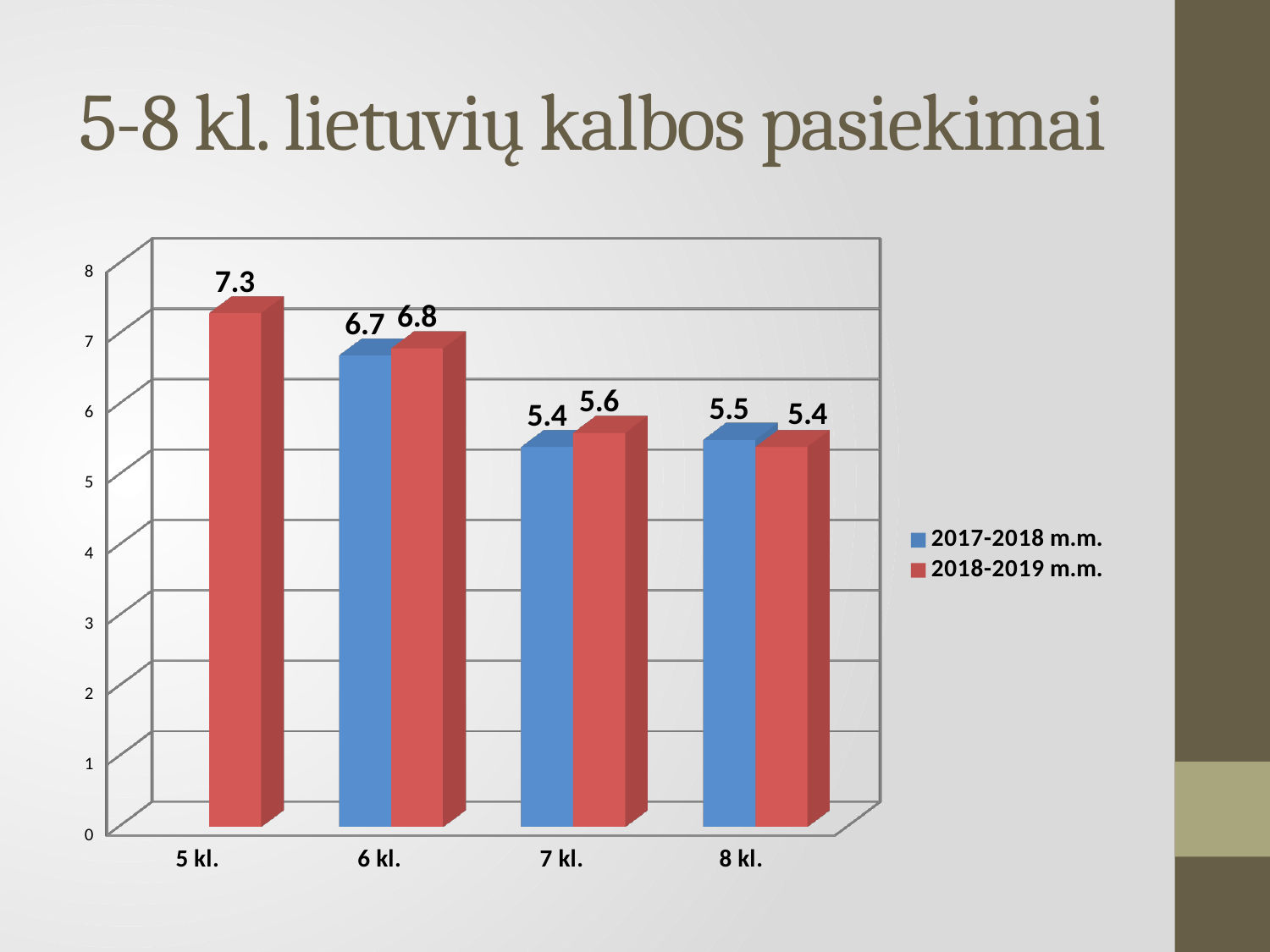
For 8 kl., which series has the larger value, 2017-2018 m.m. or 2018-2019 m.m.? 2017-2018 m.m. What is the value for 7 kl. in the 2018-2019 m.m. series? 5.6 How many classes are shown on the x axis? 4 What is the value for 6 kl. in the 2017-2018 m.m. series? 6.7 What is the title of the slide? 5-8 kl. lietuvių kalbos pasiekimai What is the value for 5 kl. in the 2018-2019 m.m. series? 7.3 What is the difference between the 2018-2019 m.m. and 2017-2018 m.m. values for 7 kl.? 0.2 What is the value for 8 kl. in the 2017-2018 m.m. series? 5.5 How many series does the legend list? 2 Which class has the highest value in the 2018-2019 m.m. series? 5 kl. What kind of chart is shown on the slide? Bar chart Which class has the lowest value in the 2017-2018 m.m. series? 7 kl.